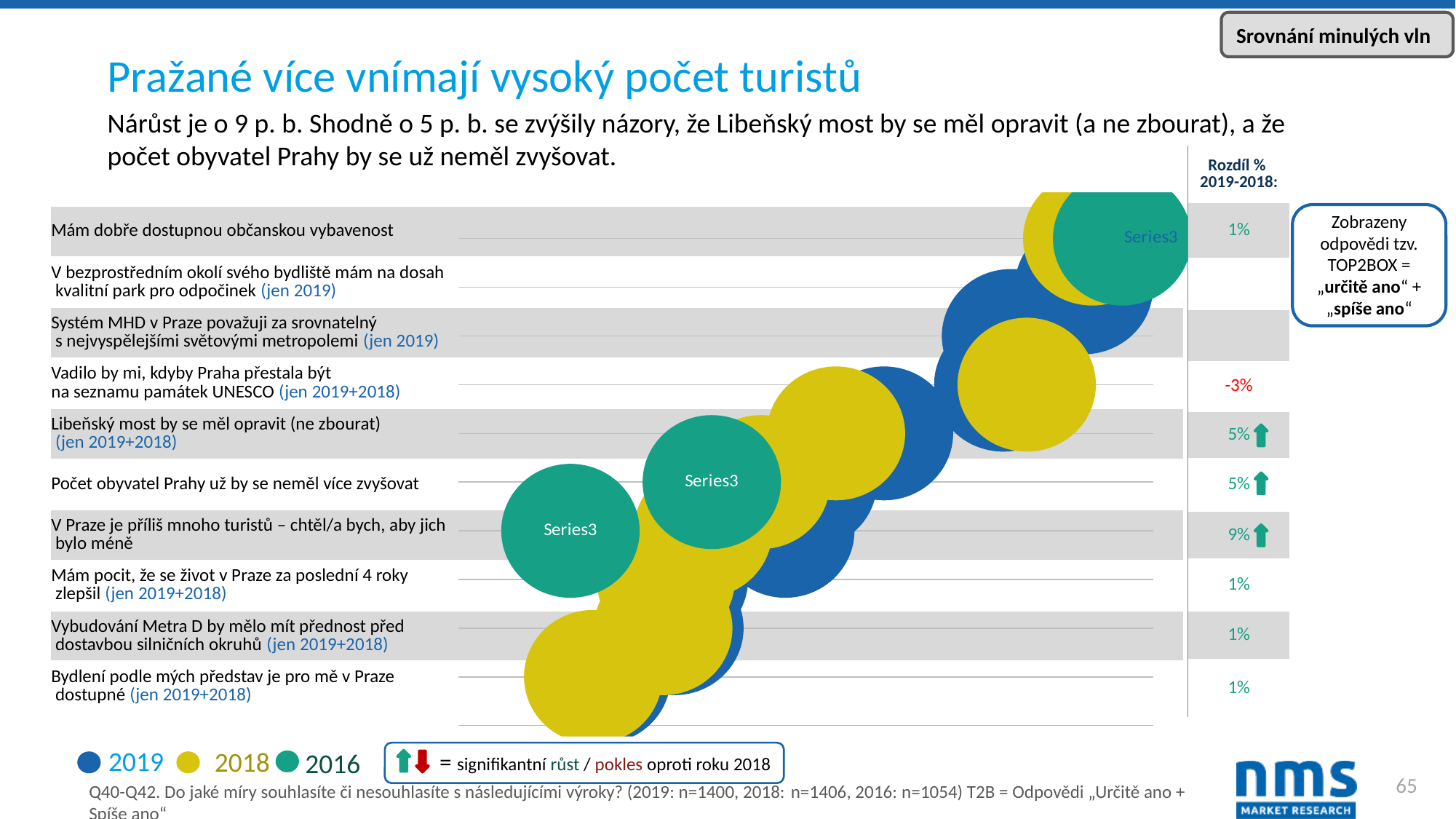
Which statement has the lowest 'Rozdíl % 2019-2018' value? Vadilo by mi, kdyby Praha přestala být na seznamu památek UNESCO How many statements (categories) are plotted on the chart? 10 What is the 'Rozdíl % 2019-2018' value for 'Vadilo by mi, kdyby Praha přestala být na seznamu památek UNESCO'? -3% Which colour represents the 2016 series in the legend? green What is the 'Rozdíl % 2019-2018' value for 'V Praze je příliš mnoho turistů – chtěl/a bych, aby jich bylo méně'? 9% What is the 'Rozdíl % 2019-2018' value for 'Mám dobře dostupnou občanskou vybavenost'? 1% Which statement has the highest 'Rozdíl % 2019-2018' value? V Praze je příliš mnoho turistů – chtěl/a bych, aby jich bylo méně What kind of chart is shown on the slide? bubble chart Which years are listed in the chart legend? 2019, 2018, 2016 What is the 'Rozdíl % 2019-2018' value for 'Libeňský most by se měl opravit (ne zbourat)'? 5% How many series does the legend list? 3 What is the 'Rozdíl % 2019-2018' value for 'Počet obyvatel Prahy už by se neměl více zvyšovat'? 5%